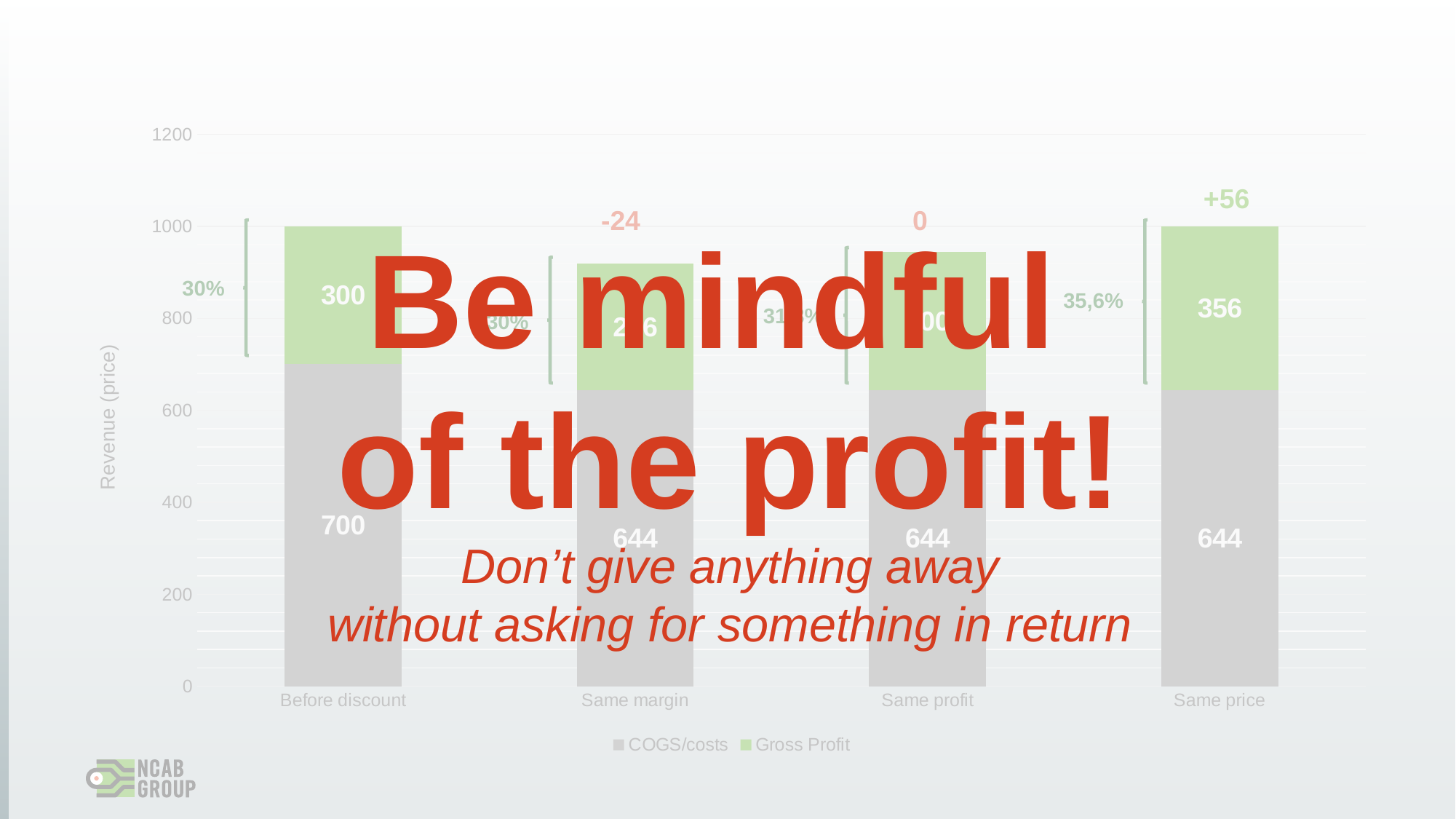
What is the difference between the Gross Profit of the Same price bar and the Before discount bar? 56 What is the total height of the Before discount stacked bar? 1000 How many categories are shown on the x axis of the chart? 4 What is the Gross Profit value for the Same price bar? 356 What kind of chart is shown on the slide? Stacked bar chart Which category has the highest COGS/costs value? Before discount Is the total of the Same margin stacked bar greater or less than 1000? less What is the COGS/costs value for the Before discount bar? 700 How many series does the chart legend list? 2 What is the label of the y axis of the chart? Revenue (price) What is the Gross Profit value for the Before discount bar? 300 What is the COGS/costs value for the Same price bar? 644